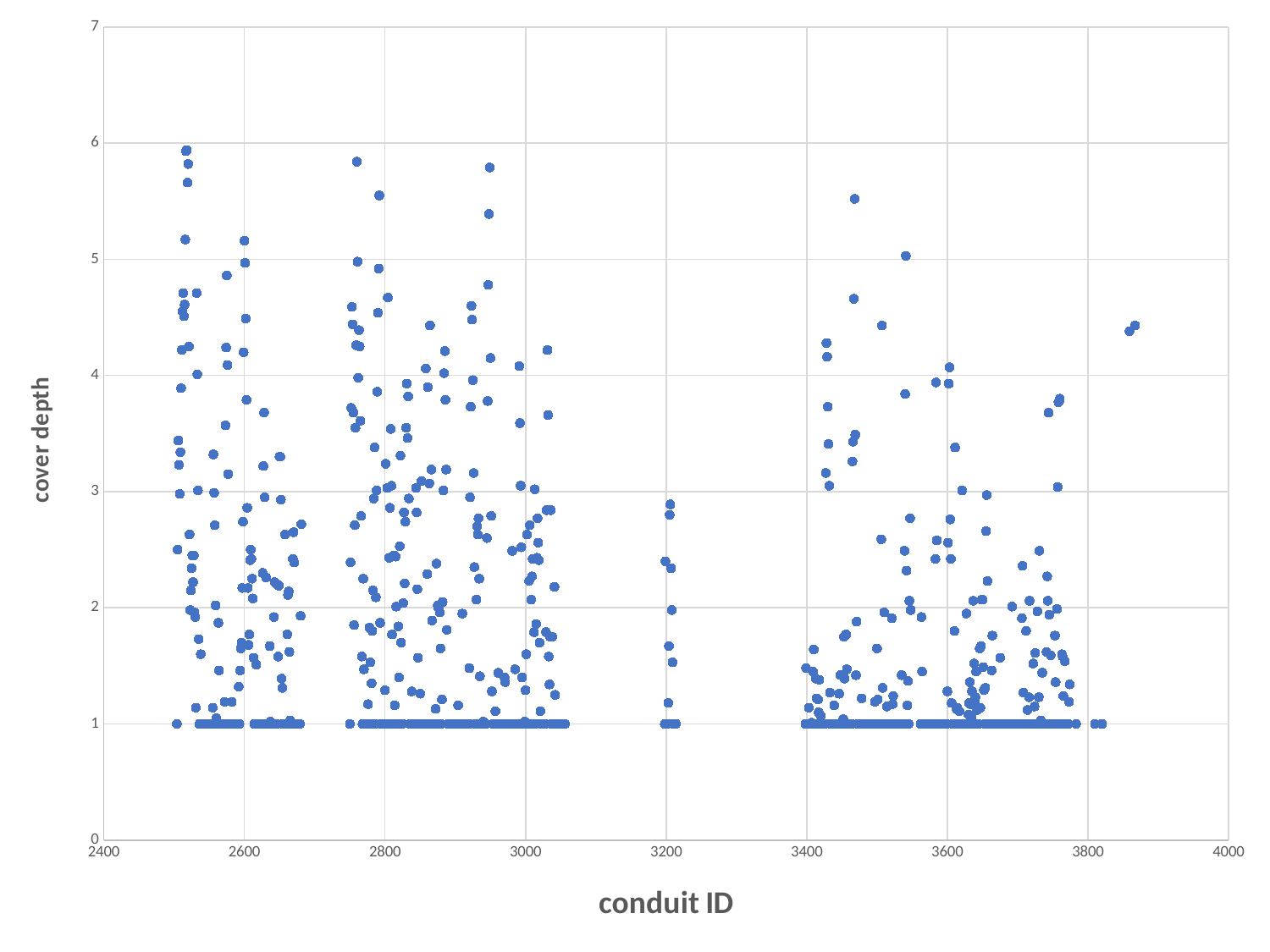
What is the label of the y axis? cover depth Is the highest cover depth for the points with conduit ID around 3200 greater or less than 4? less Is the highest cover depth plotted on the chart greater or less than 5? greater What kind of chart is shown on the slide? scatter plot Is the highest cover depth for the points with conduit ID between 2400 and 2700 greater or less than 5? greater What is the label of the x axis? conduit ID